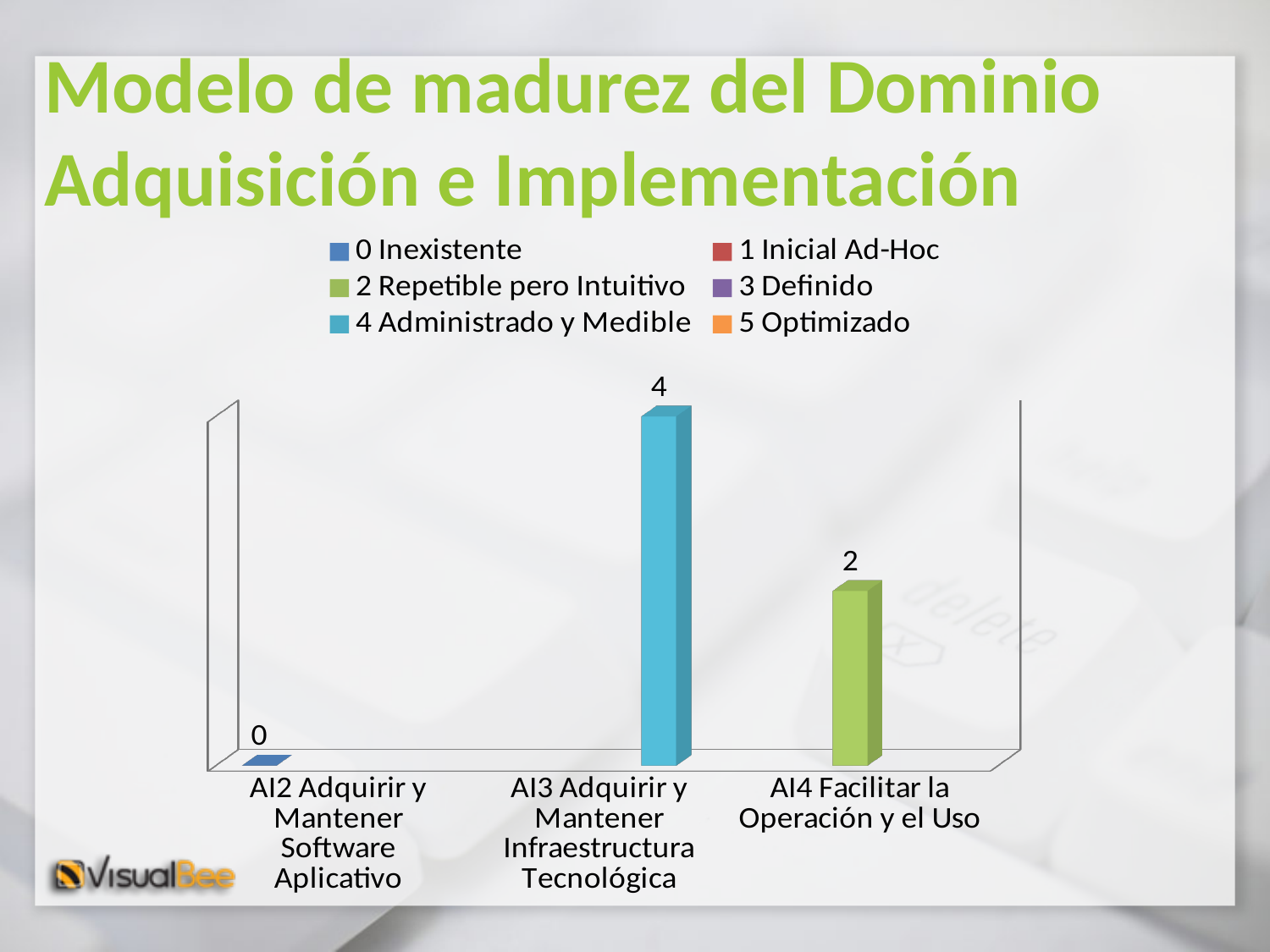
What is the value for AI3 Adquirir y Mantener Infraestructura Tecnológica? 4 What kind of chart is shown on the slide? Bar chart What is the value for AI2 Adquirir y Mantener Software Aplicativo? 0 How many categories are shown on the x axis? 3 Which category has the lowest value? AI2 Adquirir y Mantener Software Aplicativo What is the value for AI4 Facilitar la Operación y el Uso? 2 Which category has the highest value? AI3 Adquirir y Mantener Infraestructura Tecnológica What is the title of the slide? Modelo de madurez del Dominio Adquisición e Implementación Which is larger, the value for AI4 Facilitar la Operación y el Uso or the value for AI2 Adquirir y Mantener Software Aplicativo? AI4 Facilitar la Operación y el Uso How many entries does the legend list? 6 What is the difference between the values for AI3 Adquirir y Mantener Infraestructura Tecnológica and AI4 Facilitar la Operación y el Uso? 2 Which legend entry is shown in orange? 5 Optimizado